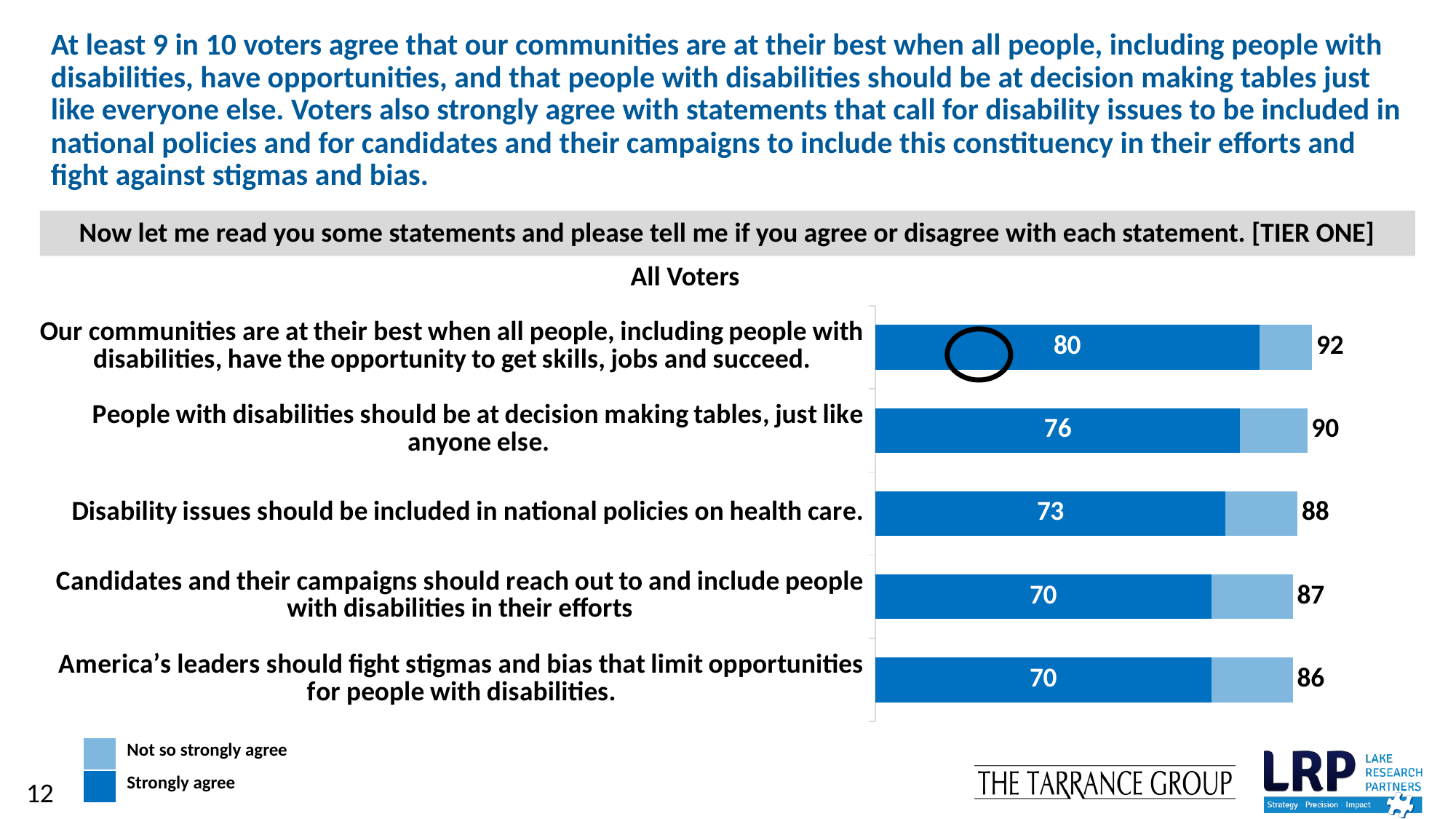
What is the difference between the total agreement and the strongly agree value for the statement about candidates and their campaigns reaching out to people with disabilities? 17 Which has a higher strongly agree value: the statement about decision making tables or the statement about national policies on health care? People with disabilities should be at decision making tables, just like anyone else. What percentage of all voters strongly agree that our communities are at their best when all people, including people with disabilities, have the opportunity to get skills, jobs and succeed? 80 What is the total agreement shown for the statement that America's leaders should fight stigmas and bias that limit opportunities for people with disabilities? 86 Which statement has the lowest total agreement? America's leaders should fight stigmas and bias that limit opportunities for people with disabilities. Which statement has the highest total agreement? Our communities are at their best when all people, including people with disabilities, have the opportunity to get skills, jobs and succeed. What is the total agreement shown for the statement that people with disabilities should be at decision making tables, just like anyone else? 90 How many statements are shown in the chart? 5 Which legend entry is shown in the lighter blue colour? Not so strongly agree What percentage strongly agree that disability issues should be included in national policies on health care? 73 How many series does the legend list? 2 What kind of chart is shown on the slide? Stacked bar chart